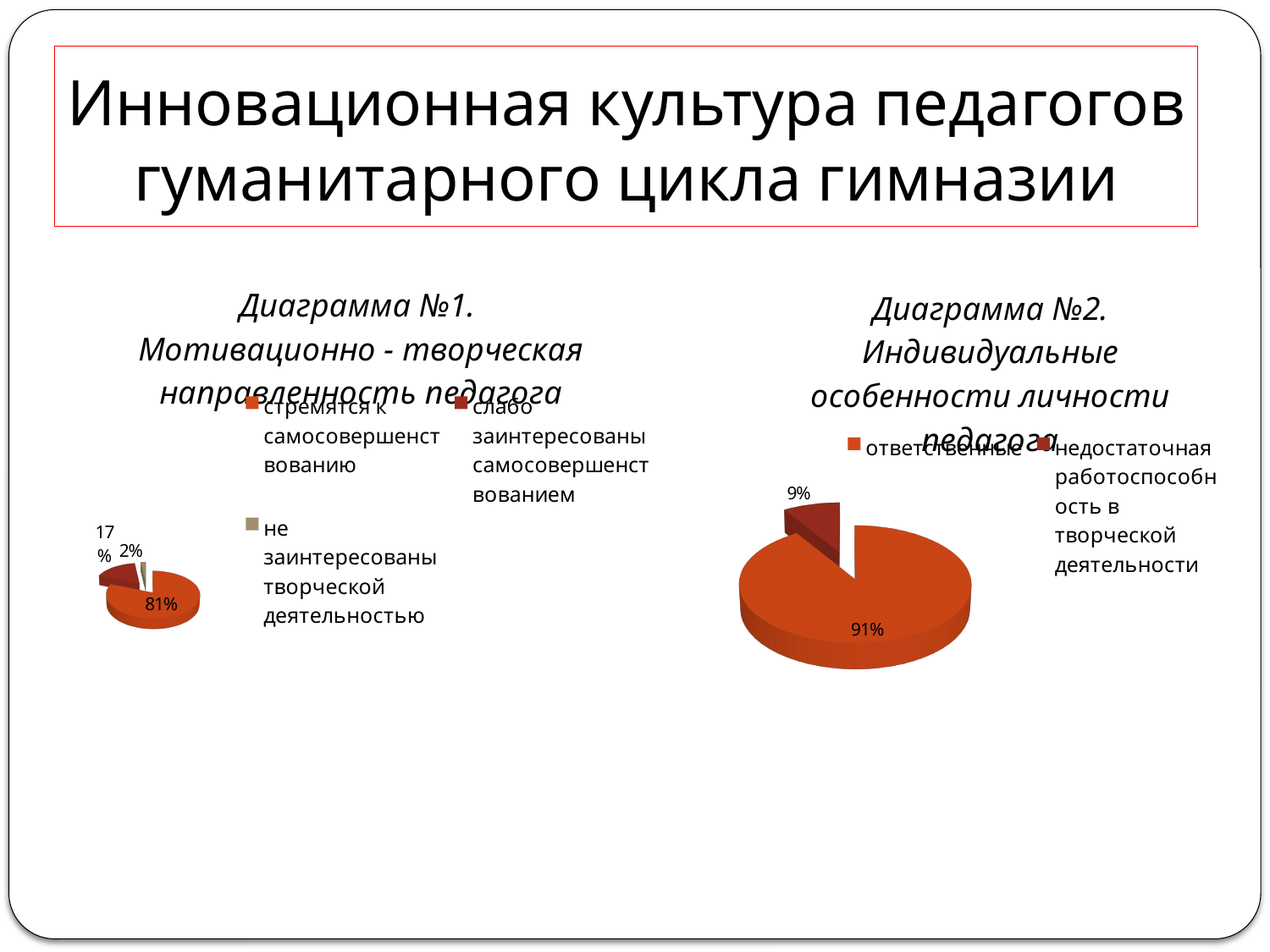
In Диаграмма №1 (left chart), what is the difference between the 81% slice and the 17% slice? 64% In Диаграмма №2 (right chart), what is the value of the slice for 'недостаточная работоспособность в творческой деятельности'? 9% In Диаграмма №2 (right chart), what is the difference between the two slices? 82% In Диаграмма №1 (left chart), what share of the pie is labelled for the largest slice? 81% What is the title of the right-hand chart on the slide? Диаграмма №2. Индивидуальные особенности личности педагога What kind of chart is Диаграмма №1 on the left of the slide? pie chart How many slices does the pie in Диаграмма №1 (left chart) have? 3 In Диаграмма №2 (right chart), which slice is larger: 'ответственные' or 'недостаточная работоспособность в творческой деятельности'? ответственные In Диаграмма №1 (left chart), what is the value of the smallest slice? 2% In Диаграмма №1 (left chart), what is the value of the slice for 'слабо заинтересованы самосовершенствованием'? 17% In Диаграмма №2 (right chart), what share of the pie is 'ответственные'? 91% How many categories does the legend of Диаграмма №2 (right chart) list? 2